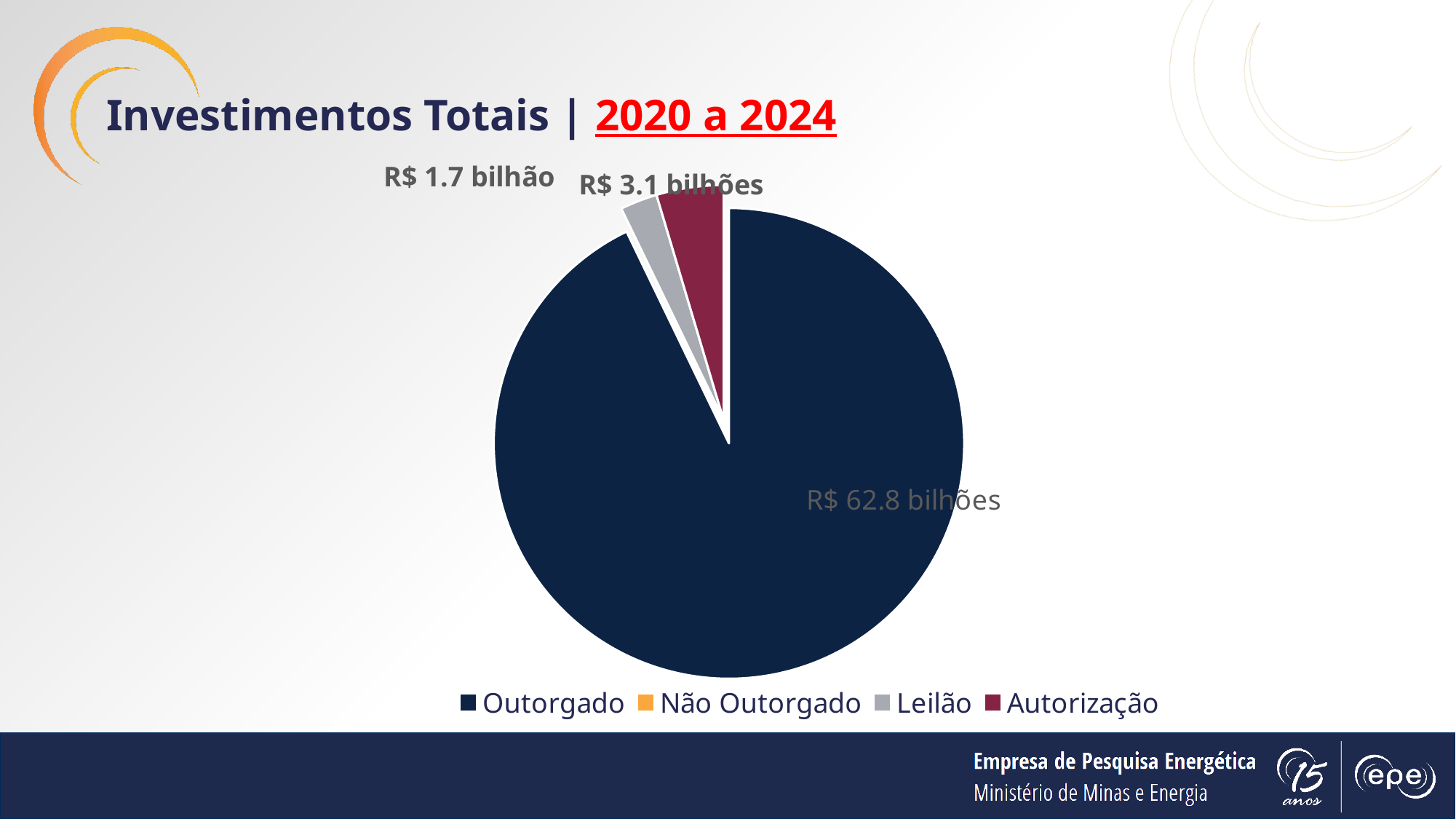
What kind of chart is shown on the slide? pie chart What is the difference between the Outorgado value and the Autorização value? R$ 59.7 bilhões What is the value shown for the Outorgado slice? R$ 62.8 bilhões What colour represents Autorização in the legend? dark red How many categories does the legend list? 4 Which is larger, the Leilão slice or the Autorização slice? Autorização What is the title of the slide? Investimentos Totais | 2020 a 2024 What is the difference between the Autorização value and the Leilão value? R$ 1.4 bilhão What is the value shown for the Autorização slice? R$ 3.1 bilhões Which category has the largest slice of the pie? Outorgado What is the value shown for the Leilão slice? R$ 1.7 bilhão